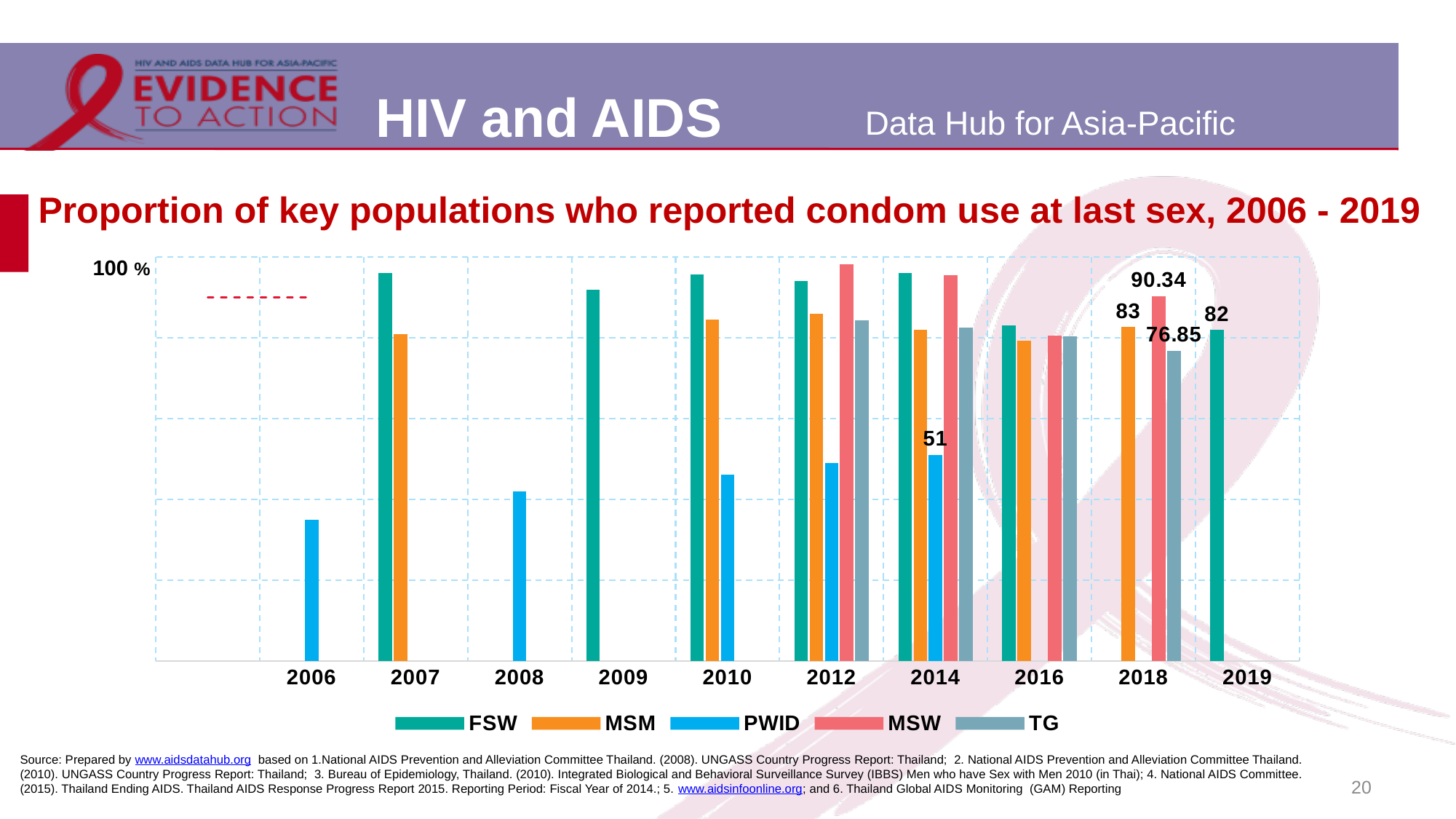
Which key population has the highest value in 2018? MSW What is the value for MSM in 2018? 83 What is the value for MSW in 2018? 90.34 What is the value for TG in 2018? 76.85 What kind of chart is shown on the slide? bar chart How many years are shown along the x axis? 10 What is the difference between the MSW and MSM values in 2018? 7.34 How many series does the legend list? 5 Which is larger in 2018, the MSW value or the TG value? MSW What is the value for FSW in 2019? 82 Does the PWID value rise or fall from 2006 to 2014? rise What is the value for PWID in 2014? 51